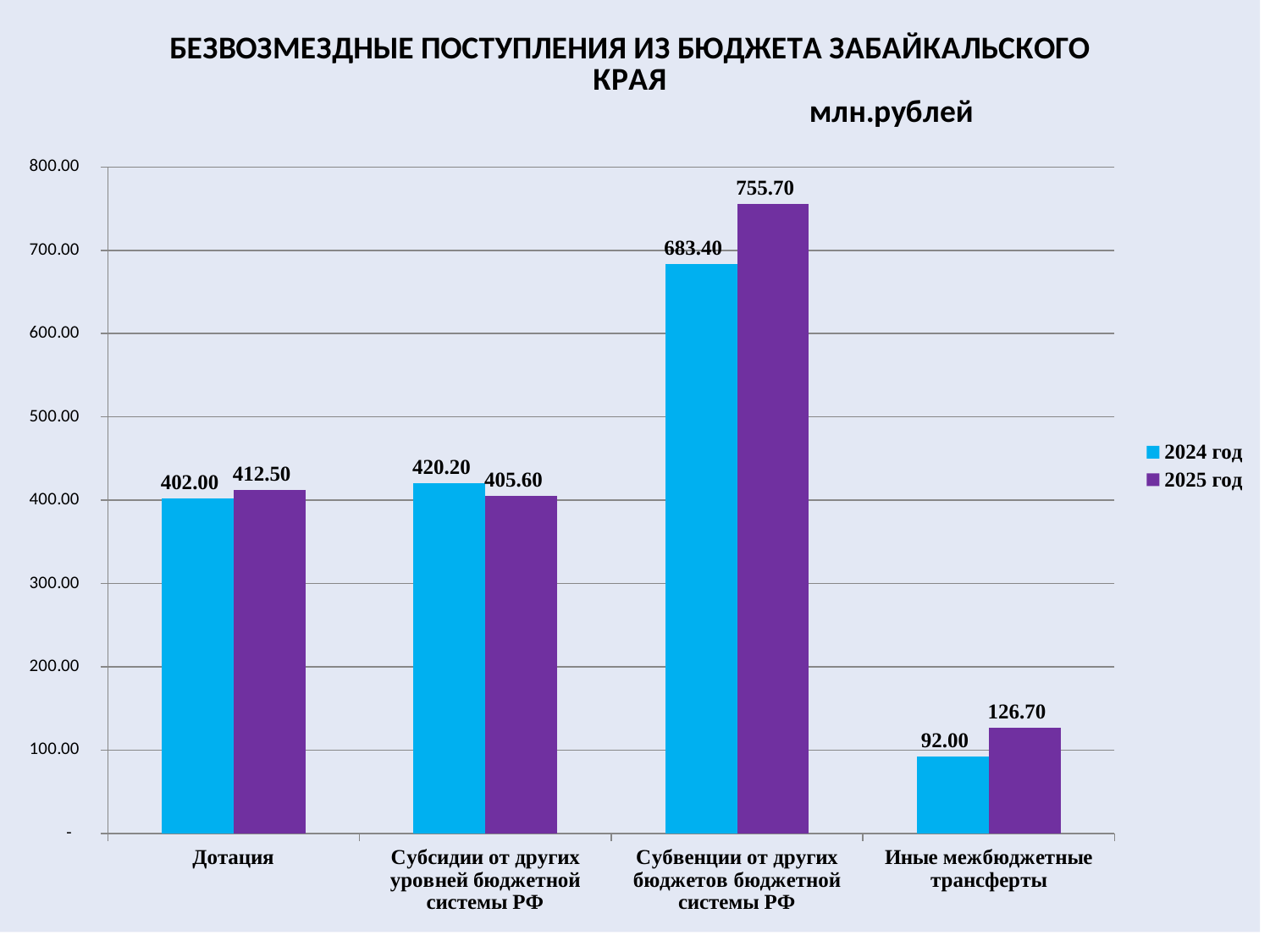
Which category has the highest value in 2025 год? Субвенции от других бюджетов бюджетной системы РФ Which category has the lowest value in 2024 год? Иные межбюджетные трансферты What is the value for Субвенции от других бюджетов бюджетной системы РФ in 2025 год? 755.70 What is the difference between the 2025 год and 2024 год values for Иные межбюджетные трансферты? 34.70 What is the difference between the 2025 год and 2024 год values for Субвенции от других бюджетов бюджетной системы РФ? 72.30 What is the value for Дотация in 2024 год? 402.00 What unit is stated for the values on the chart? млн.рублей What kind of chart is shown on the slide? Bar chart How many categories are shown on the x axis? 4 For Субсидии от других уровней бюджетной системы РФ, which year has the larger value, 2024 год or 2025 год? 2024 год What is the value for Иные межбюджетные трансферты in 2024 год? 92.00 How many series does the legend list? 2